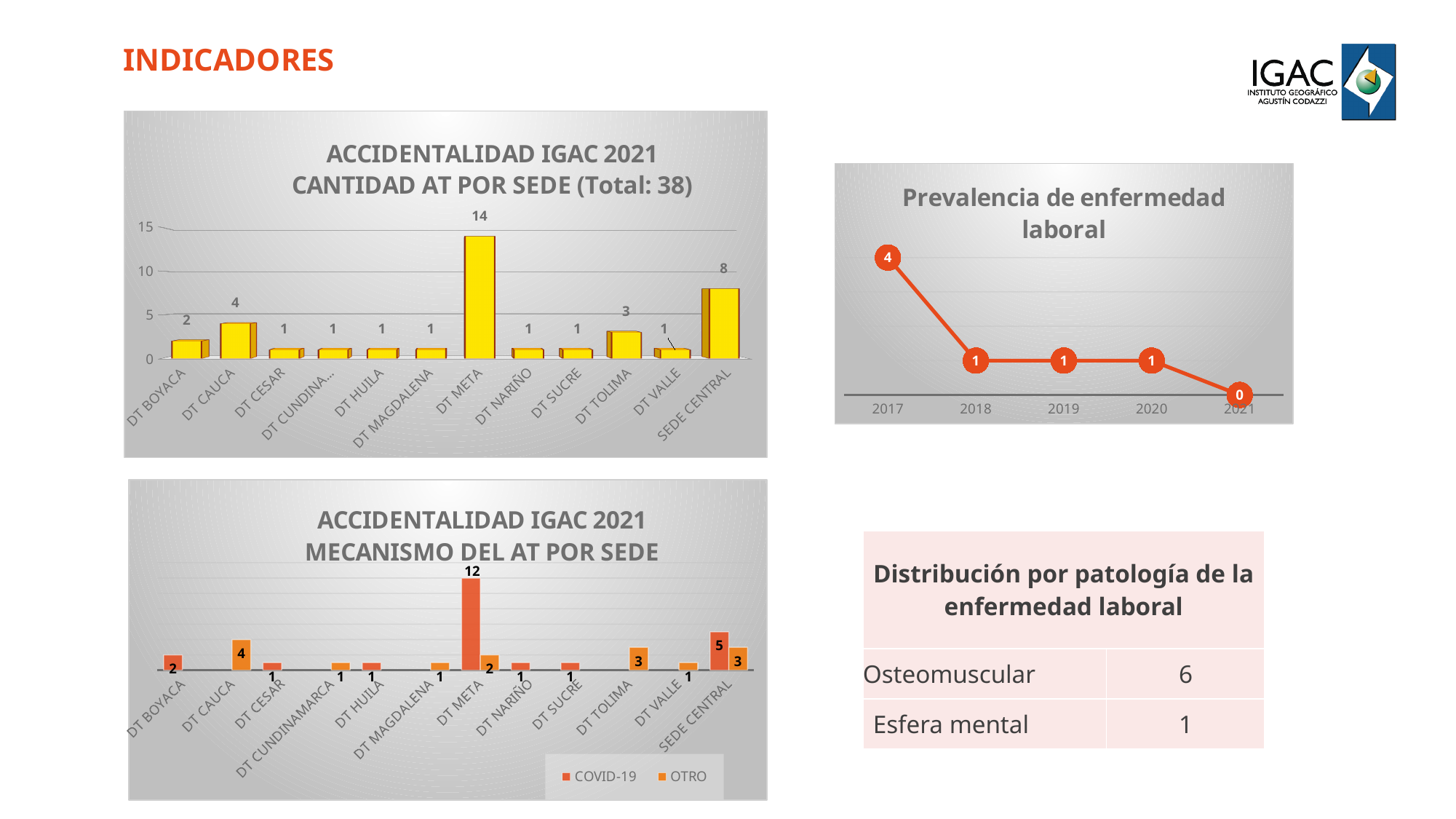
How many series does the legend of the chart 'ACCIDENTALIDAD IGAC 2021 MECANISMO DEL AT POR SEDE' list? 2 In the chart 'Prevalencia de enfermedad laboral', which year has the lowest value? 2021 In the chart 'ACCIDENTALIDAD IGAC 2021 CANTIDAD AT POR SEDE', which sede has the highest value? DT META What type of chart is 'Prevalencia de enfermedad laboral'? Line chart In the chart 'Prevalencia de enfermedad laboral', what is the value for 2017? 4 In the chart 'ACCIDENTALIDAD IGAC 2021 CANTIDAD AT POR SEDE', how many sedes are shown on the x axis? 12 In the chart 'ACCIDENTALIDAD IGAC 2021 CANTIDAD AT POR SEDE', what is the value for DT META? 14 In the chart 'ACCIDENTALIDAD IGAC 2021 CANTIDAD AT POR SEDE', what is the difference between DT META and SEDE CENTRAL? 6 In the chart 'ACCIDENTALIDAD IGAC 2021 MECANISMO DEL AT POR SEDE', what is the COVID-19 value for DT META? 12 In the chart 'ACCIDENTALIDAD IGAC 2021 CANTIDAD AT POR SEDE', which is larger, DT CAUCA or DT TOLIMA? DT CAUCA In the chart 'Prevalencia de enfermedad laboral', do the values rise or fall from 2017 to 2021? Fall In the chart 'ACCIDENTALIDAD IGAC 2021 CANTIDAD AT POR SEDE', what is the value for SEDE CENTRAL? 8